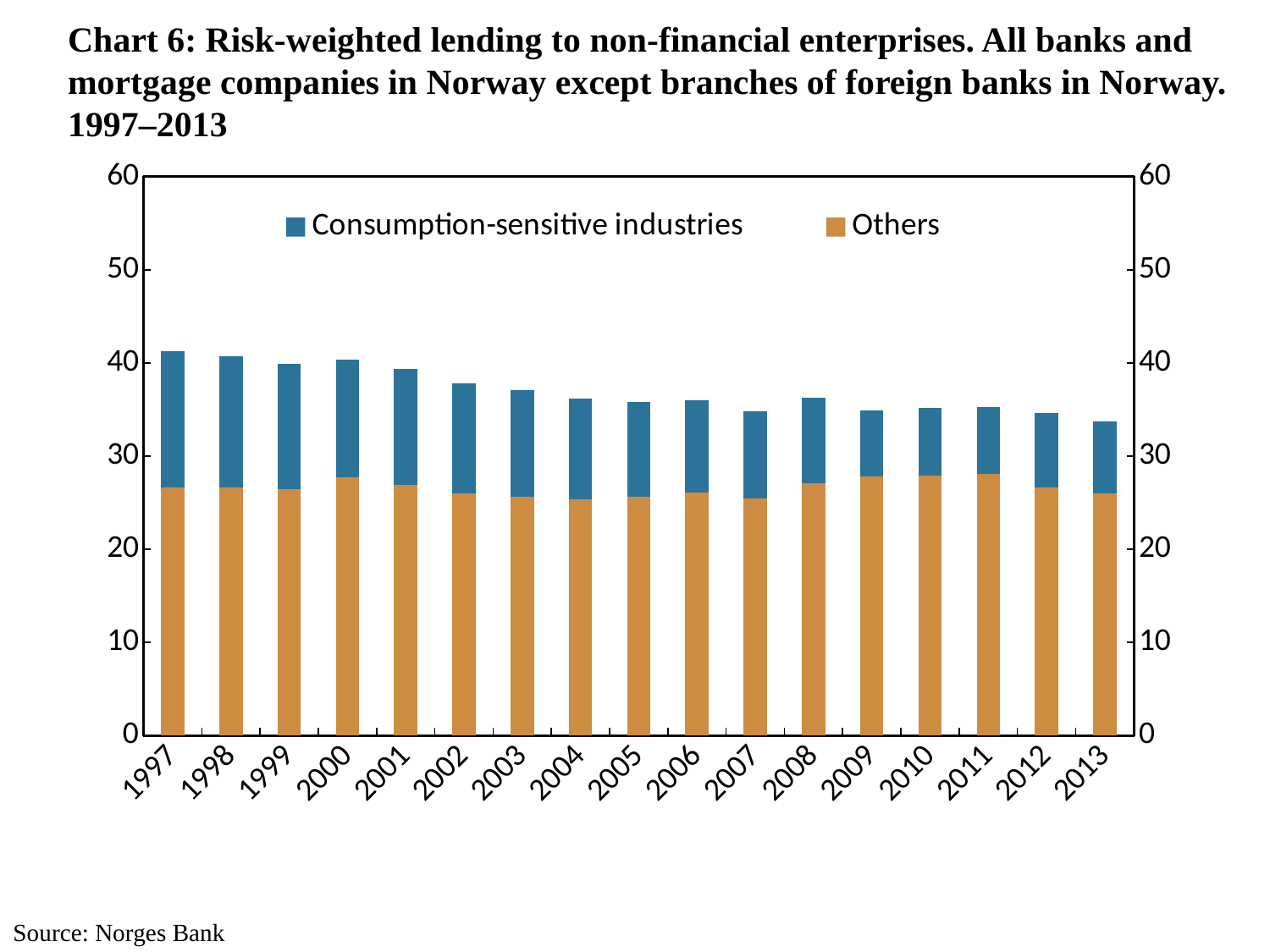
Do the total bar heights generally rise or fall from 1997 to 2013? fall Is the total bar height for 1997 greater or less than 40? greater What kind of chart is shown on the slide? Stacked bar chart Which two series are listed in the legend? Consumption-sensitive industries and Others Which year has the larger total bar, 1997 or 2013? 1997 How many years are shown along the x axis of the chart? 17 Is the value of the Others segment for 1997 greater or less than 30? less What is the source given for the chart? Norges Bank Is the value of the Others segment for 2005 greater or less than 20? greater How many series does the legend list? 2